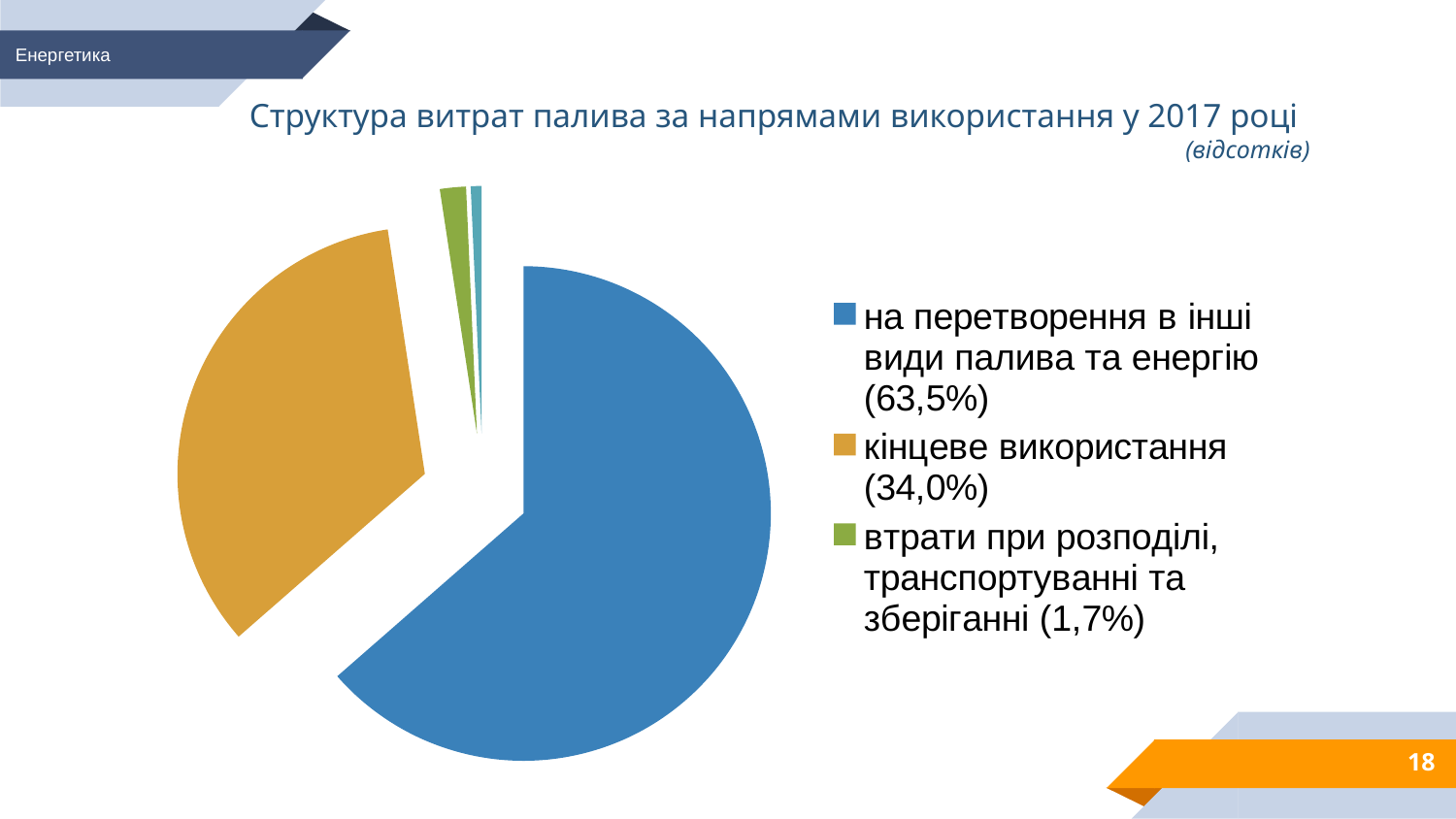
What type of chart is shown on the slide? pie chart What share of fuel expenditure goes to "кінцеве використання"? 34,0% What is the title of the chart? Структура витрат палива за напрямами використання у 2017 році What colour is the slice for "кінцеве використання"? orange Which is larger: the share for "кінцеве використання" or the share for "втрати при розподілі, транспортуванні та зберіганні"? кінцеве використання How many categories does the legend list? 3 Which category has the largest share of the pie? на перетворення в інші види палива та енергію What share of fuel expenditure is "втрати при розподілі, транспортуванні та зберіганні"? 1,7% What share of fuel expenditure goes to "на перетворення в інші види палива та енергію"? 63,5% Is the share for "на перетворення в інші види палива та енергію" greater or less than 50%? greater Which labelled category has the smallest share of the pie? втрати при розподілі, транспортуванні та зберіганні What is the difference in percentage points between "на перетворення в інші види палива та енергію" and "кінцеве використання"? 29,5